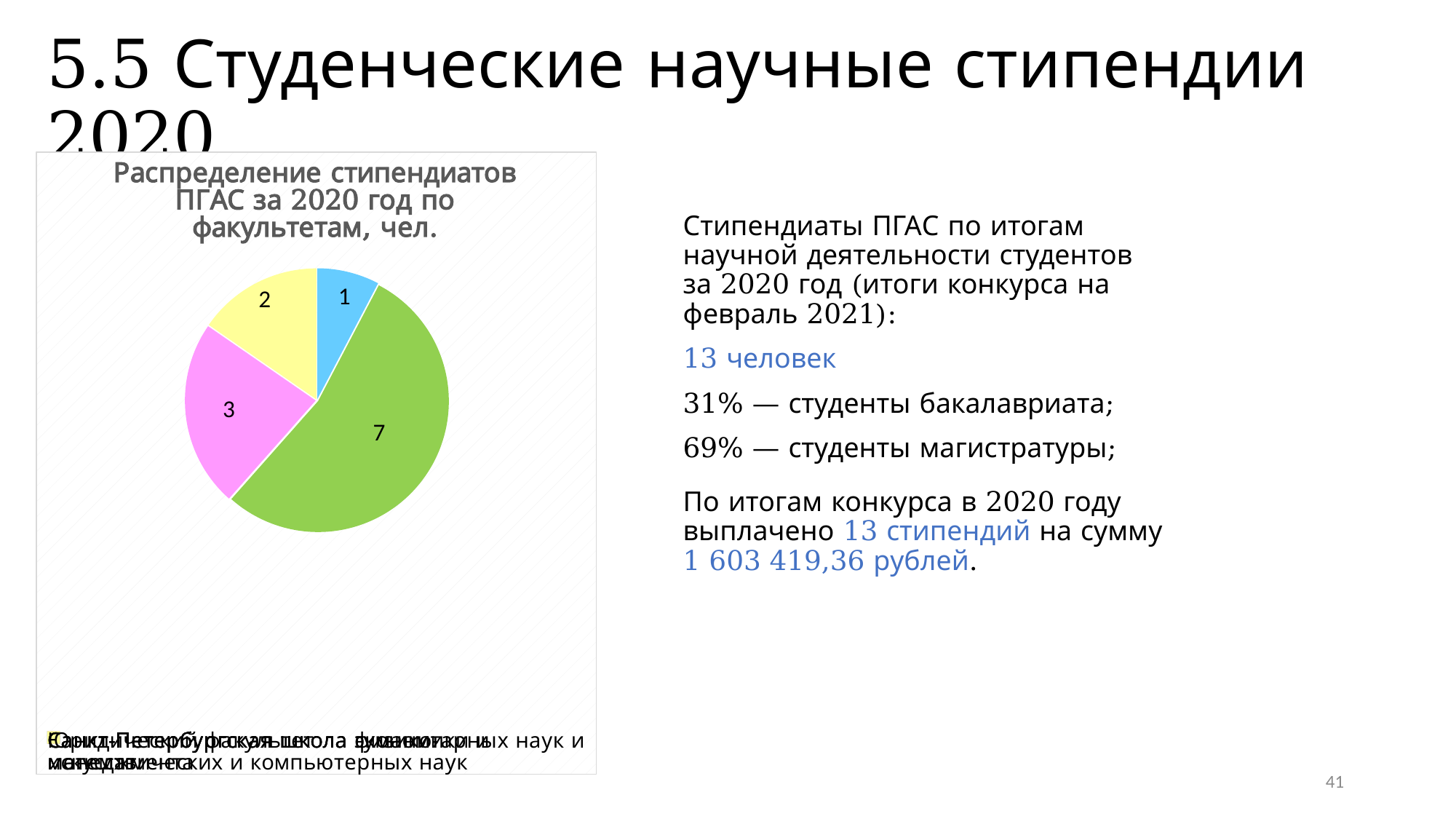
What is the difference between the green slice value and the pink slice value? 4 Which colour slice of the pie chart has the largest value? green Which colour slice of the pie chart has the smallest value? blue What is the total of all the slice values in the pie chart? 13 How many slices does the pie chart have? 4 What value is labelled on the yellow slice of the pie chart? 2 Which slice has a larger value, the pink slice or the yellow slice? pink What kind of chart is shown on the slide? pie chart What value is labelled on the blue slice of the pie chart? 1 What value is labelled on the green slice of the pie chart? 7 What is the title of the pie chart? Распределение стипендиатов ПГАС за 2020 год по факультетам, чел. What value is labelled on the pink slice of the pie chart? 3